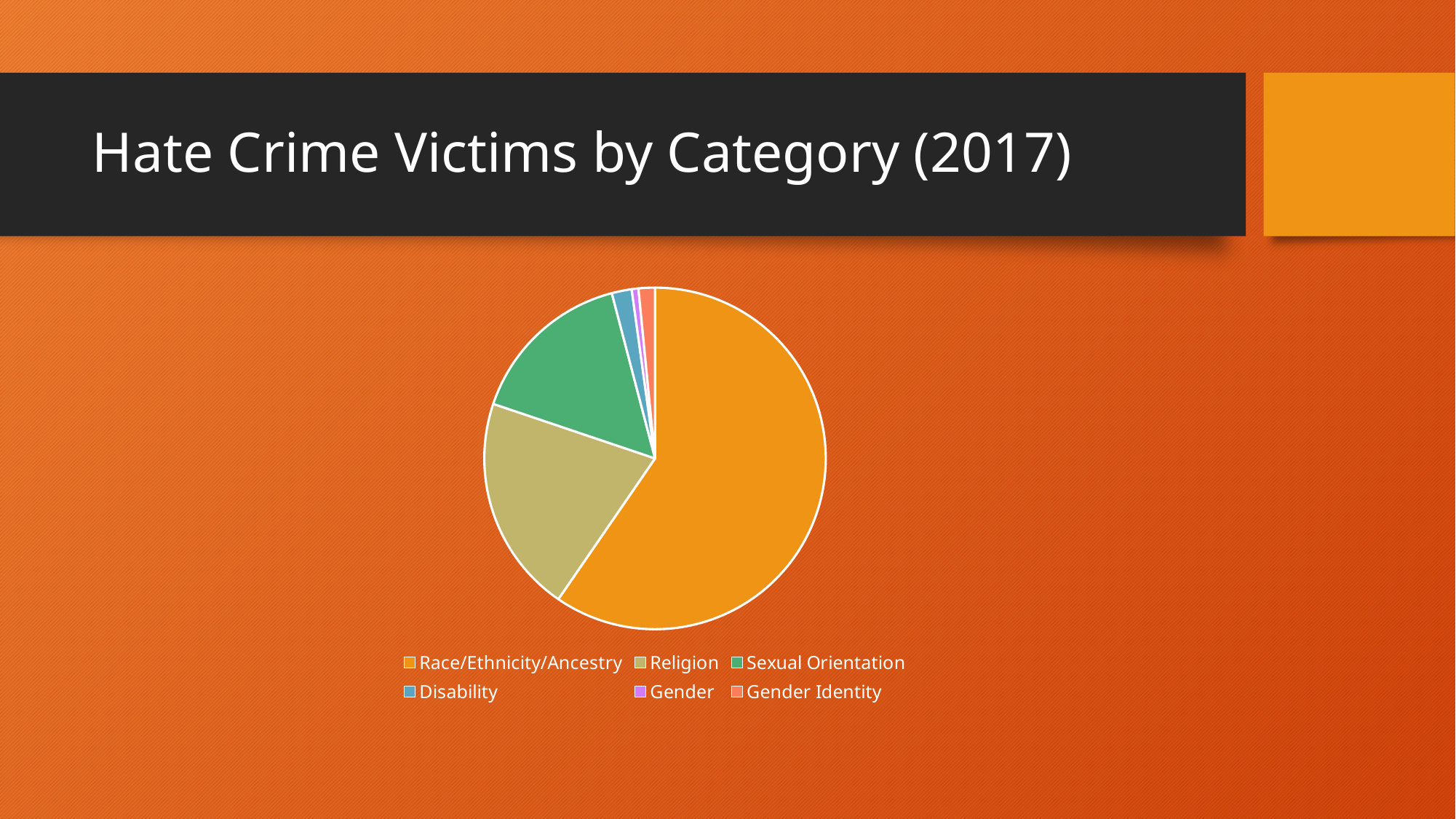
What is the title of the chart? Hate Crime Victims by Category (2017) Does the Race/Ethnicity/Ancestry slice make up more or less than half of the pie? more What kind of chart is shown on the slide? pie chart Which category has the largest slice of the pie? Race/Ethnicity/Ancestry Which slice is larger, Religion or Sexual Orientation? Religion Which slice is larger, Disability or Gender? Disability Which category is represented by the green slice? Sexual Orientation Which slice is larger, Sexual Orientation or Disability? Sexual Orientation How many categories does the pie chart show? 6